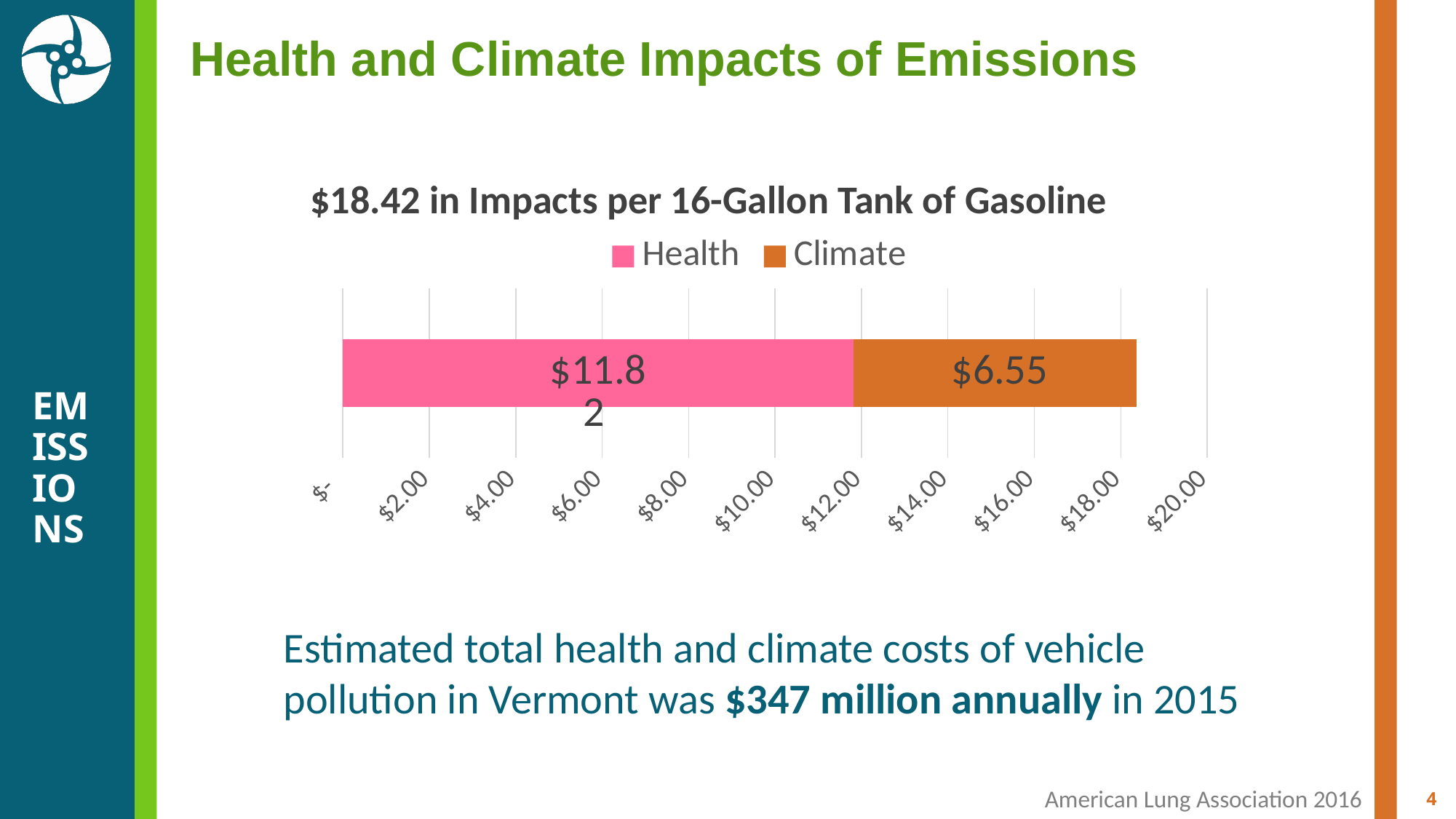
How many bars are plotted in the chart? 1 What is the total of the stacked bar? $18.37 Is the Climate value greater or less than $8.00? less How many series does the legend list? 2 What is the title of the chart? $18.42 in Impacts per 16-Gallon Tank of Gasoline What colour represents the Climate series in the chart? Orange What is the value of the Health segment in the stacked bar? $11.82 What kind of chart is shown on the slide? Stacked bar chart Which series has the larger value, Health or Climate? Health Is the Health value greater or less than $10.00? greater What is the value of the Climate segment in the stacked bar? $6.55 What is the difference between the Health and Climate values? $5.27